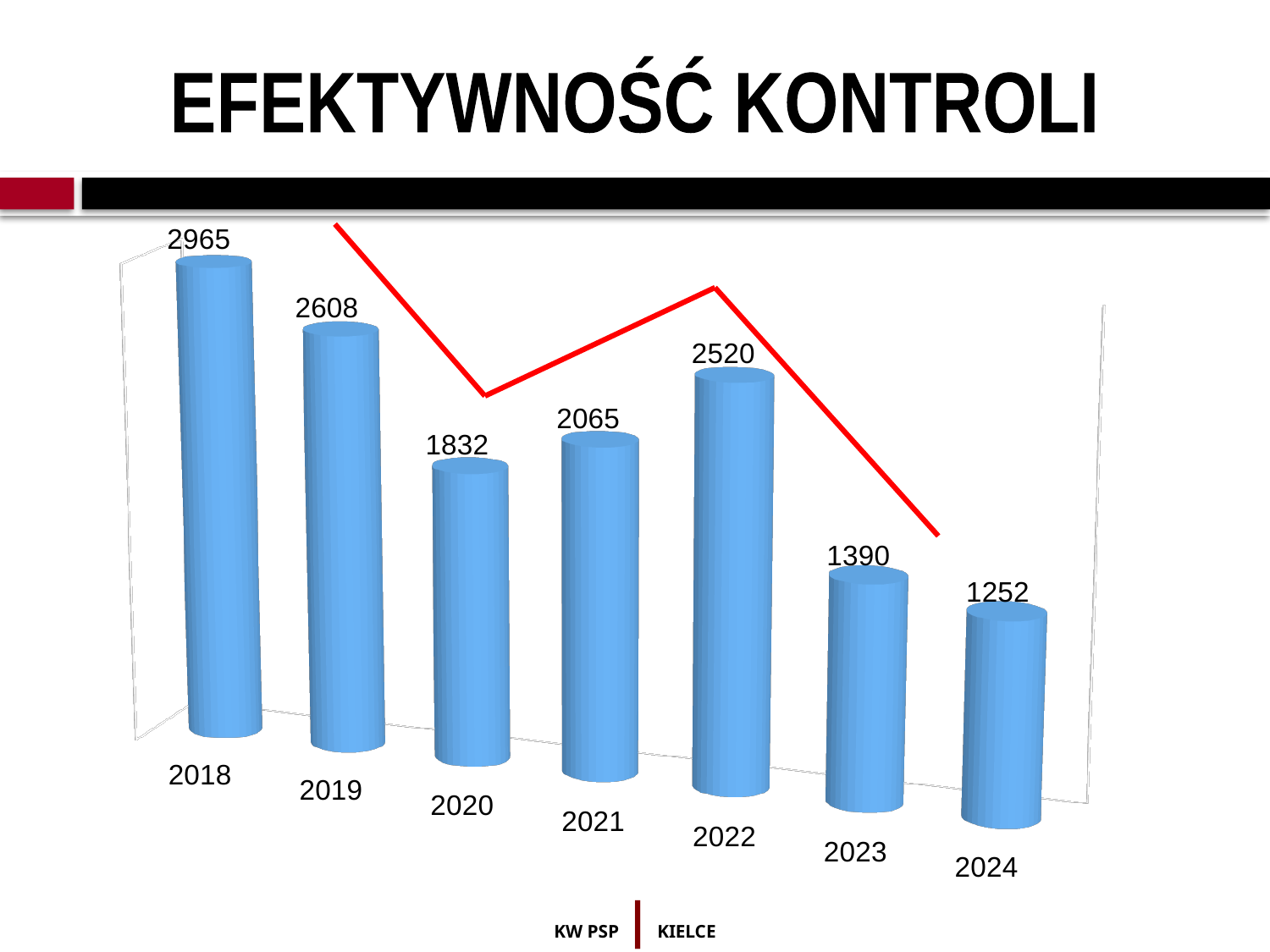
Which is larger, the value for 2020 or the value for 2021? 2021 What is the value for 2018? 2965 What is the difference between the values for 2018 and 2019? 357 What is the value for 2021? 2065 What is the value for 2024? 1252 What kind of chart is shown on the slide? bar chart What is the title of the slide? EFEKTYWNOŚĆ KONTROLI Which year has the lowest value? 2024 Do the values rise or fall from 2022 to 2024? fall What is the difference between the values for 2022 and 2023? 1130 How many years are shown on the chart? 7 Which year has the highest value? 2018